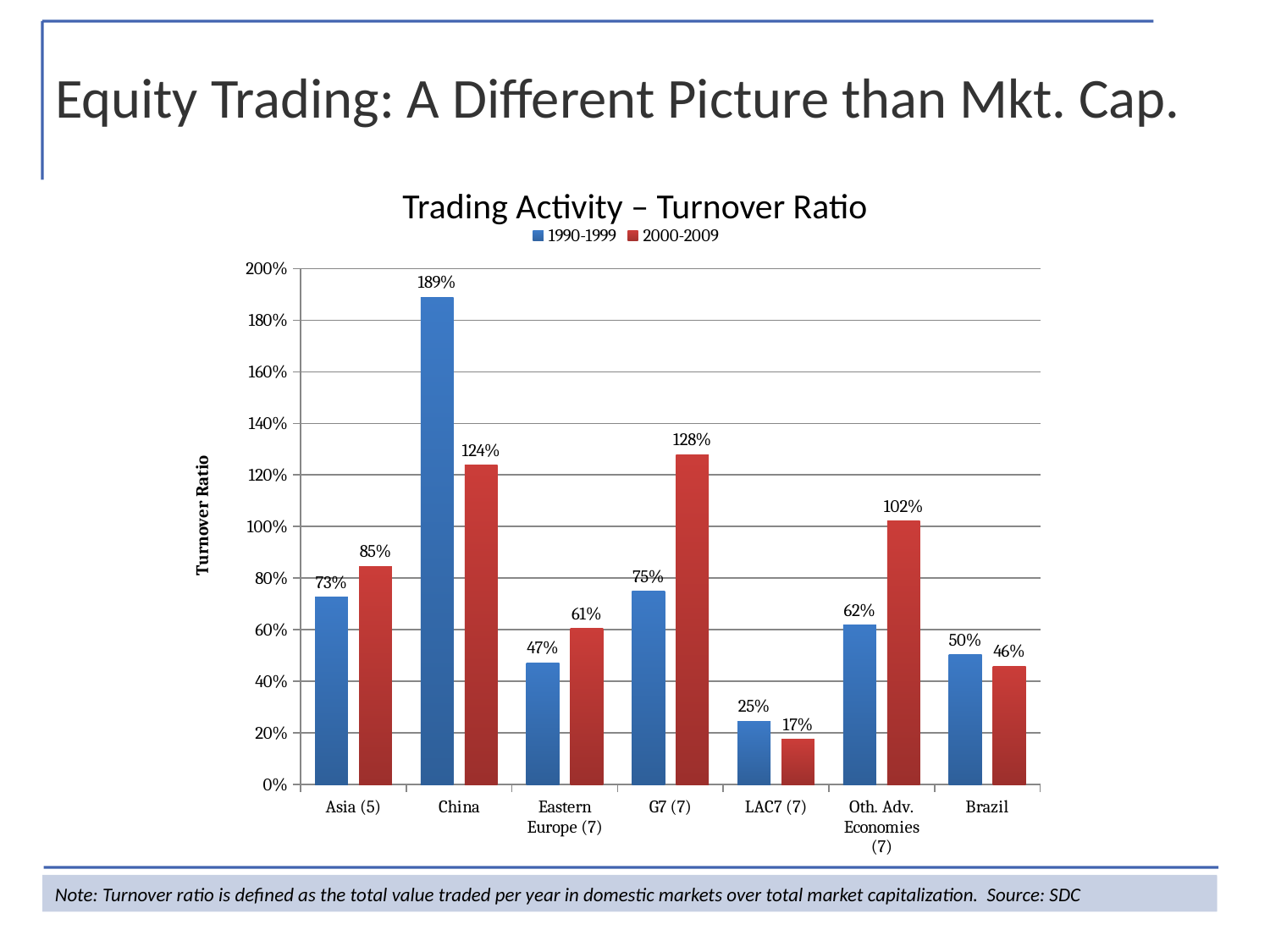
How many series does the legend list? 2 What is the difference between the 2000-2009 and 1990-1999 turnover ratios for Eastern Europe (7)? 14% Is the 2000-2009 turnover ratio for Asia (5) greater or less than 80%? greater What is the turnover ratio for LAC7 (7) in 2000-2009? 17% How many categories are shown on the x axis? 7 Which category has the highest turnover ratio in the 2000-2009 series? G7 (7) What is the turnover ratio for Oth. Adv. Economies (7) in 2000-2009? 102% What is the turnover ratio for China in 1990-1999? 189% What is the title of the chart? Trading Activity – Turnover Ratio Which category has the lowest turnover ratio in the 1990-1999 series? LAC7 (7) What kind of chart is shown on the slide? Bar chart Which is larger for Brazil: the 1990-1999 turnover ratio or the 2000-2009 turnover ratio? 1990-1999